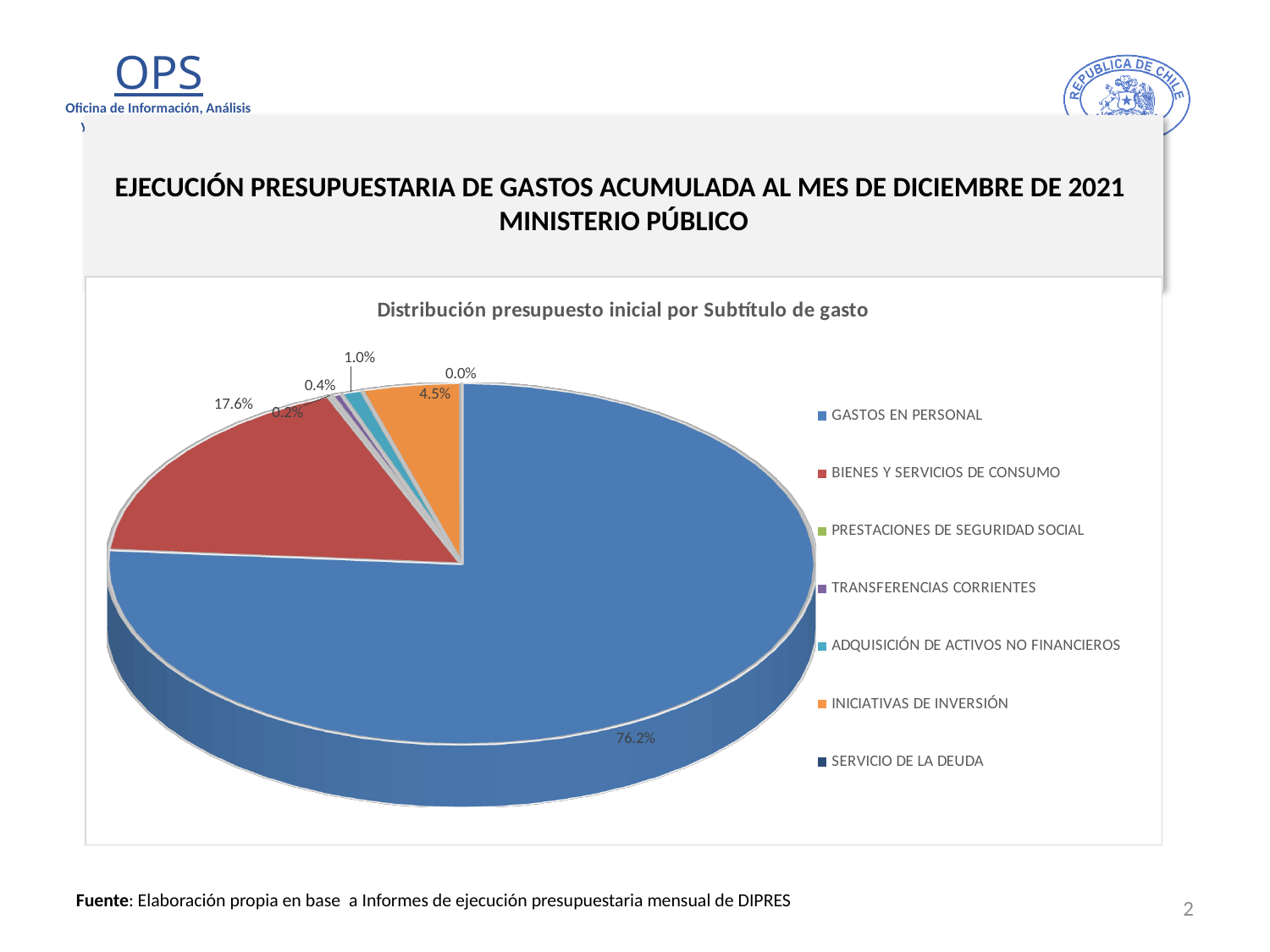
What share of the pie does INICIATIVAS DE INVERSIÓN represent? 4.5% What is the difference in percentage points between GASTOS EN PERSONAL and BIENES Y SERVICIOS DE CONSUMO? 58.6 What share of the pie does GASTOS EN PERSONAL represent? 76.2% What kind of chart is shown on the slide? pie chart Which is larger, the share for INICIATIVAS DE INVERSIÓN or the share for ADQUISICIÓN DE ACTIVOS NO FINANCIEROS? INICIATIVAS DE INVERSIÓN Which category has the largest slice of the pie? GASTOS EN PERSONAL How many categories does the legend of the pie chart list? 7 What share of the pie does SERVICIO DE LA DEUDA represent? 0.0% Which category has the smallest slice of the pie? SERVICIO DE LA DEUDA What is the title of the chart? Distribución presupuesto inicial por Subtítulo de gasto